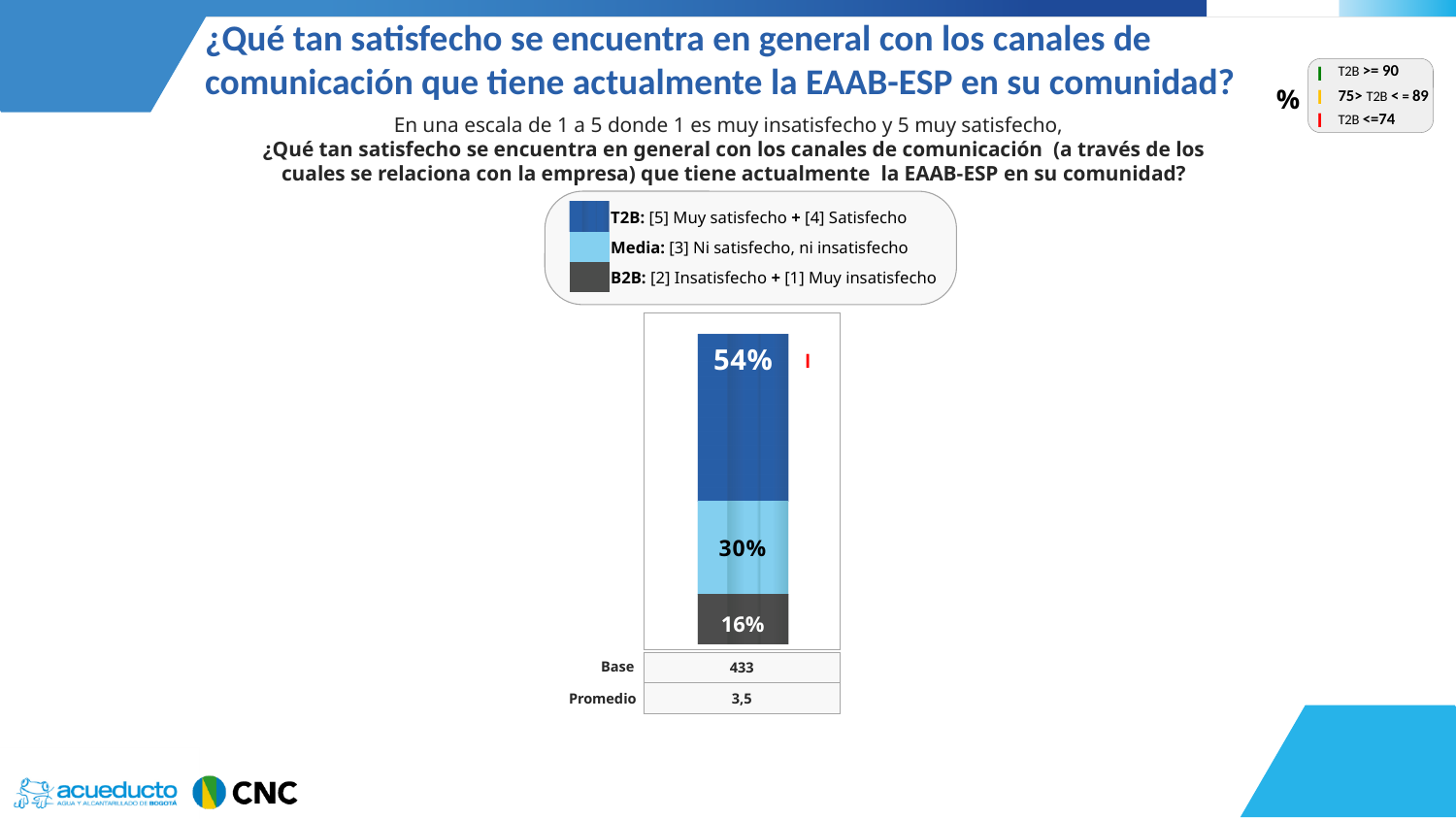
What is the difference between the T2B percentage and the B2B percentage? 38% Which segment of the stacked bar is the largest? T2B What is the total of the three segments in the stacked bar? 100% Which segment of the stacked bar is the smallest? B2B What percentage of respondents are in the B2B group (dissatisfied or very dissatisfied)? 16% What is the Base (number of respondents) shown below the chart? 433 What percentage of respondents are in the T2B group (satisfied or very satisfied)? 54% What is the difference between the Media percentage and the B2B percentage? 14% What percentage of respondents are in the Media group (neither satisfied nor dissatisfied)? 30% How many segments make up the stacked bar? 3 What is the Promedio (average) shown below the chart? 3,5 Which is larger, the T2B share or the Media share? T2B